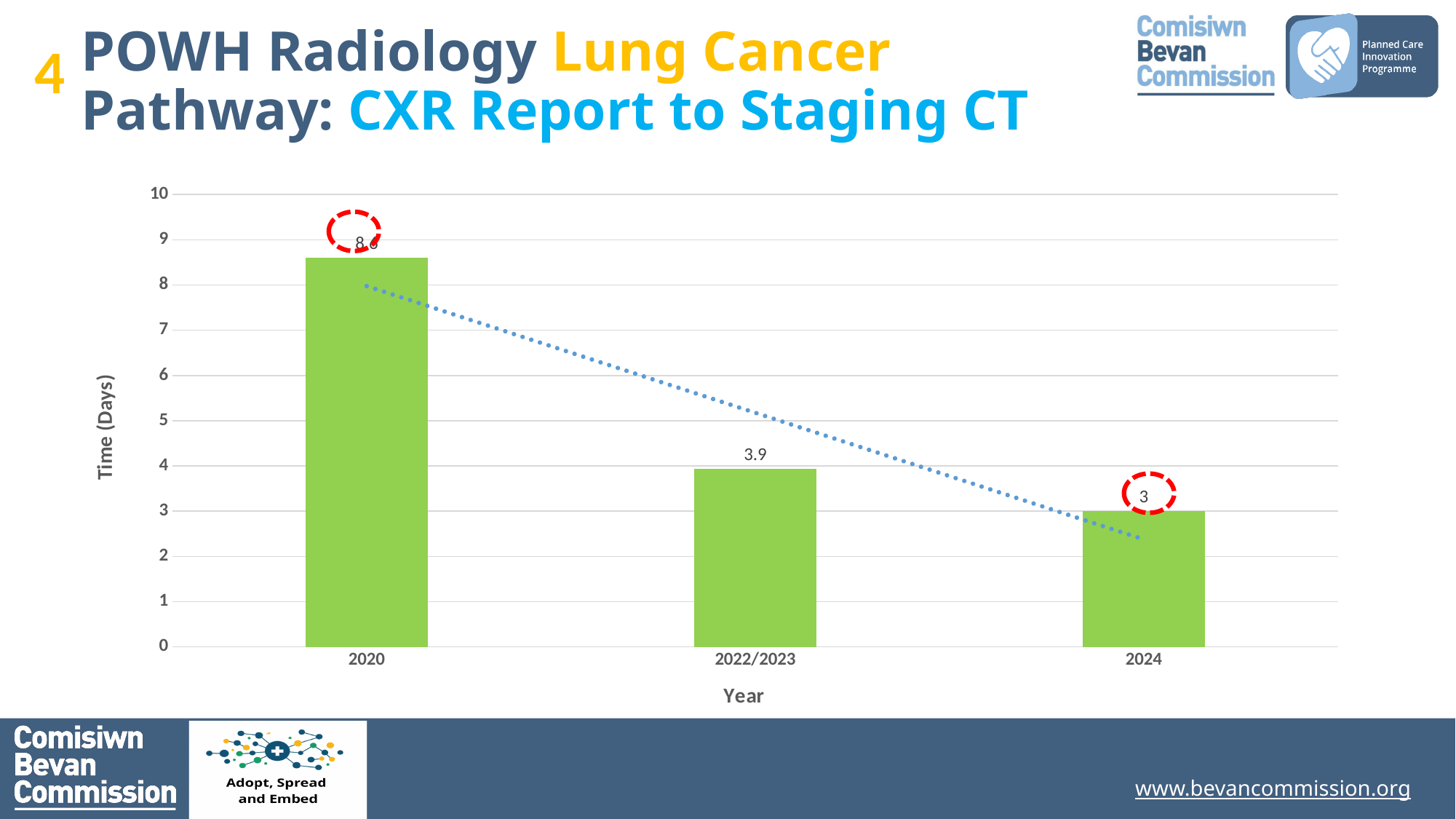
What is the difference between the values for 2022/2023 and 2024? 0.9 Which year has the lowest value? 2024 What is the value for 2022/2023? 3.9 What kind of chart is shown on the slide? Bar chart What is the value for 2024? 3 What is the title of the vertical axis? Time (Days) Is the value for 2020 greater or less than 8? greater Is the value for 2022/2023 greater or less than 5? less Do the values rise or fall from 2020 to 2024? Fall How many years are shown on the x axis? 3 Which is larger, the value for 2022/2023 or the value for 2024? 2022/2023 Which year has the highest value? 2020